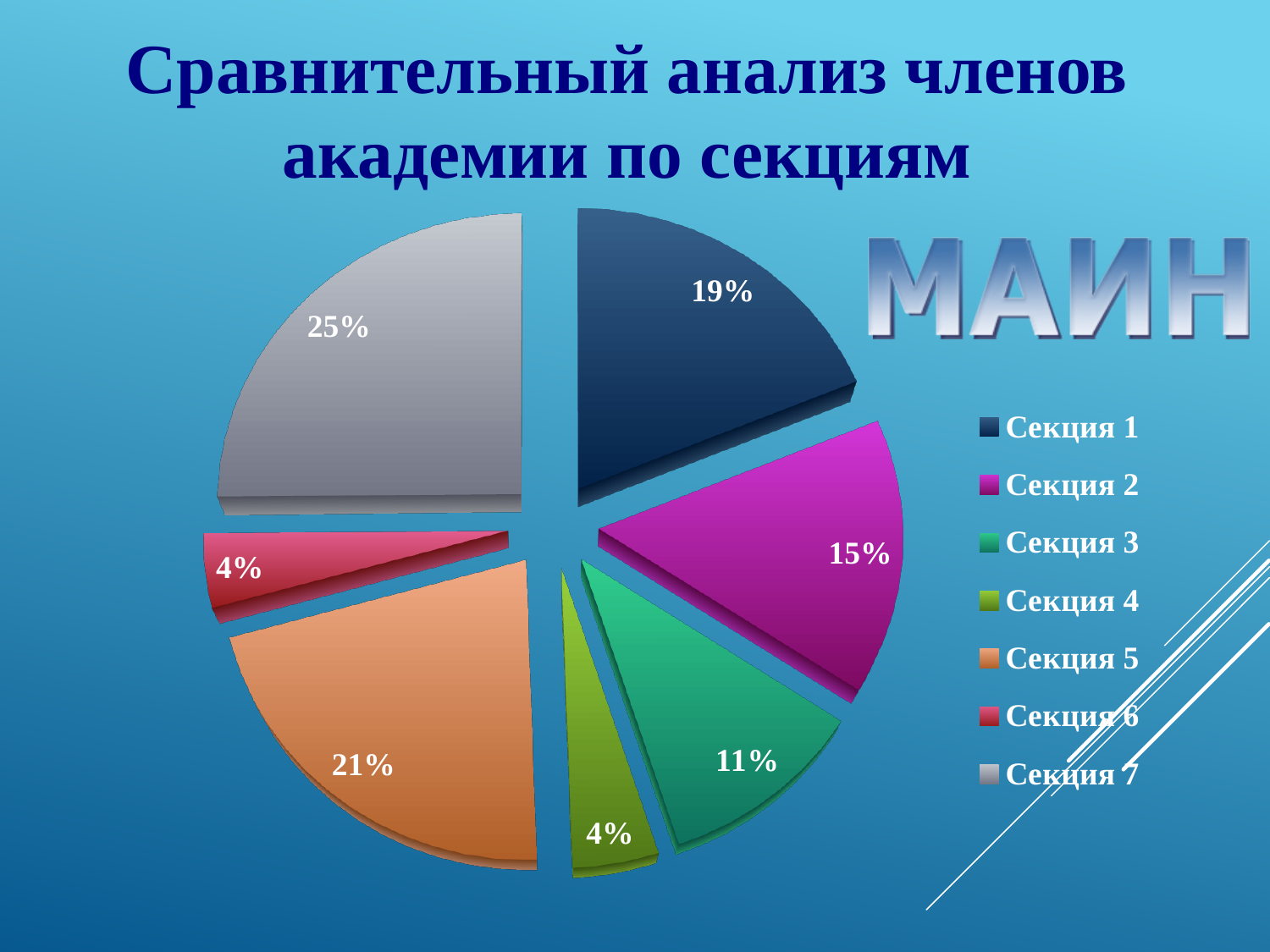
What share of the pie does Секция 2 have? 15% What is the title of the slide containing the chart? Сравнительный анализ членов академии по секциям What colour is the slice for Секция 5? orange What kind of chart is shown on the slide? pie chart What share of the pie does Секция 5 have? 21% What share of the pie does Секция 3 have? 11% How many sections does the legend list? 7 Which section has a larger share, Секция 1 or Секция 2? Секция 1 What is the difference in percentage points between the shares of Секция 7 and Секция 5? 4 Which section has the largest share of the pie? Секция 7